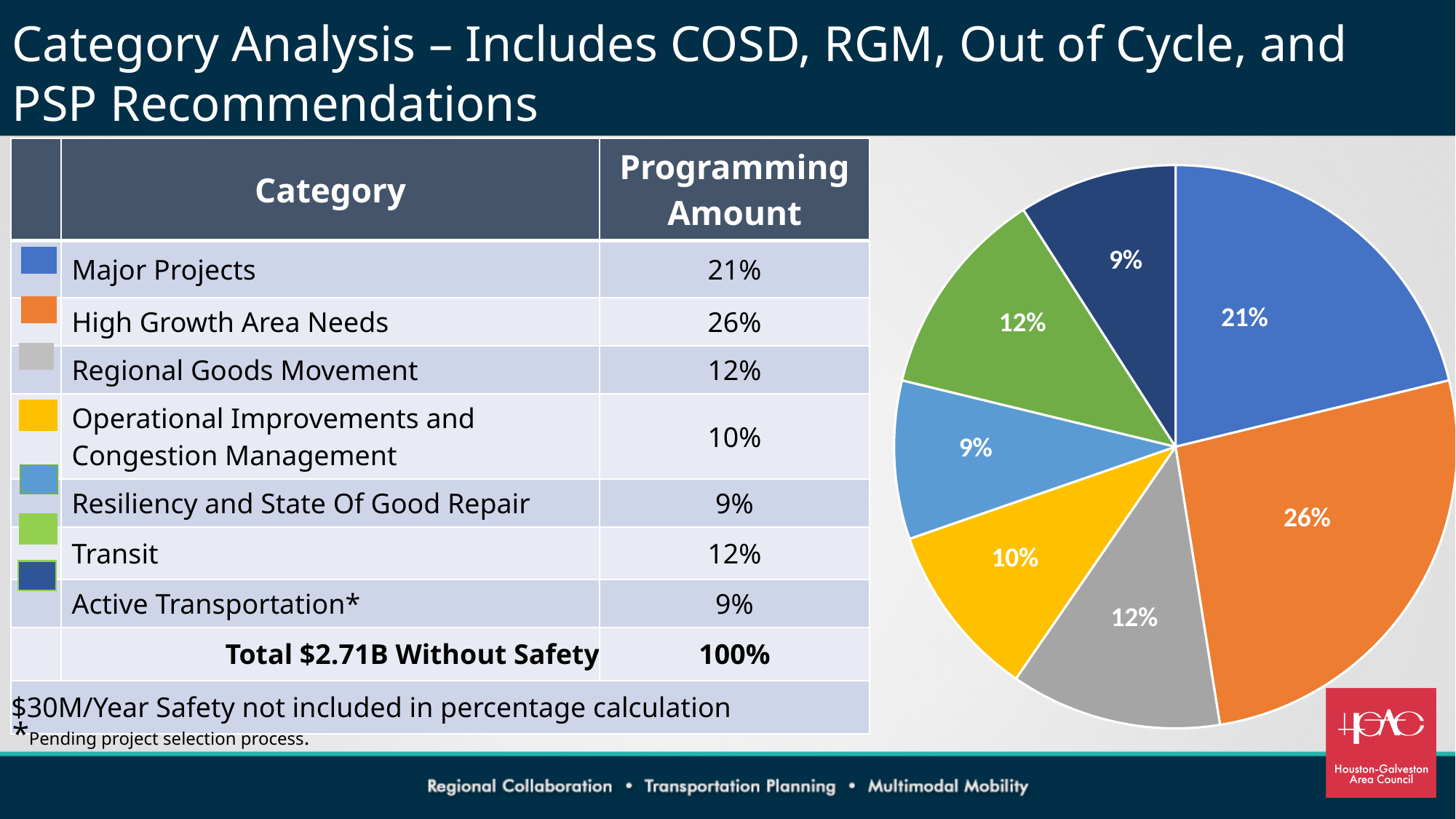
What share of the pie does High Growth Area Needs (orange slice) represent? 26% Which is larger, the slice for Regional Goods Movement or the slice for Resiliency and State Of Good Repair? Regional Goods Movement What total dollar amount does the table say the percentages are based on? $2.71B How many slices does the pie chart have? 7 What kind of chart is shown on the slide? pie chart What is the difference in percentage points between High Growth Area Needs and Major Projects? 5% Which category has the largest slice of the pie? High Growth Area Needs What is the value shown for Operational Improvements and Congestion Management (yellow slice)? 10% What colour is the slice for Regional Goods Movement? gray What is the difference between the Transit slice and the Active Transportation slice? 3% What is the value shown for Transit (green slice)? 12% What share of the pie does Major Projects (blue slice) represent? 21%